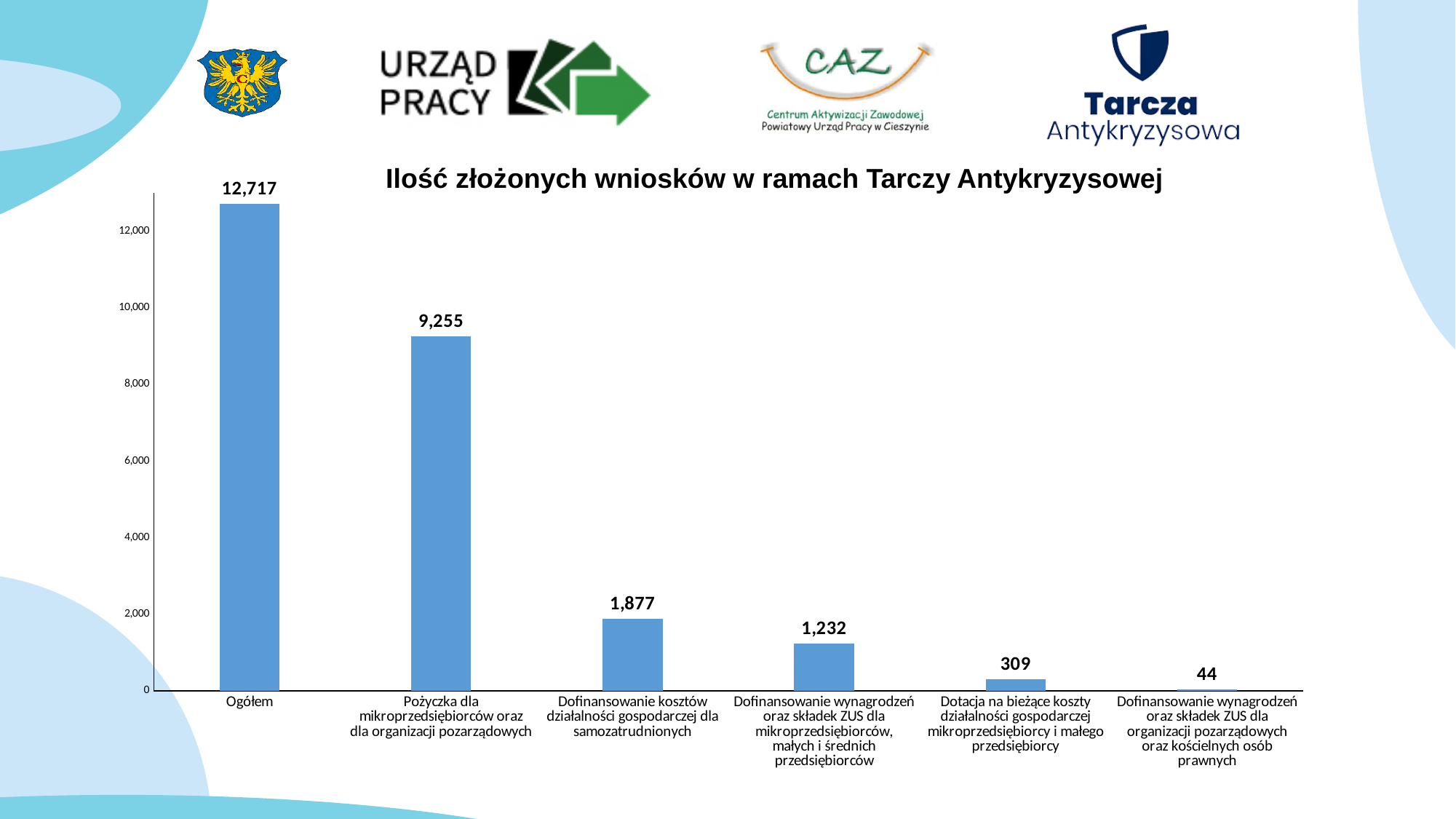
What kind of chart is shown on the slide? Bar chart How many categories are shown on the x axis? 6 What is the difference between the values for Ogółem and Pożyczka dla mikroprzedsiębiorców oraz dla organizacji pozarządowych? 3,462 What is the value for Pożyczka dla mikroprzedsiębiorców oraz dla organizacji pozarządowych? 9,255 What is the title of the chart? Ilość złożonych wniosków w ramach Tarczy Antykryzysowej Which category has the highest value? Ogółem What is the value for Dofinansowanie kosztów działalności gospodarczej dla samozatrudnionych? 1,877 What is the value for Ogółem? 12,717 What is the value for Dotacja na bieżące koszty działalności gospodarczej mikroprzedsiębiorcy i małego przedsiębiorcy? 309 What is the difference between the values for Dofinansowanie kosztów działalności gospodarczej dla samozatrudnionych and Dofinansowanie wynagrodzeń oraz składek ZUS dla mikroprzedsiębiorców, małych i średnich przedsiębiorców? 645 Which is larger: the value for Dotacja na bieżące koszty działalności gospodarczej mikroprzedsiębiorcy i małego przedsiębiorcy or the value for Dofinansowanie wynagrodzeń oraz składek ZUS dla mikroprzedsiębiorców, małych i średnich przedsiębiorców? Dofinansowanie wynagrodzeń oraz składek ZUS dla mikroprzedsiębiorców, małych i średnich przedsiębiorców Which category has the lowest value? Dofinansowanie wynagrodzeń oraz składek ZUS dla organizacji pozarządowych oraz kościelnych osób prawnych